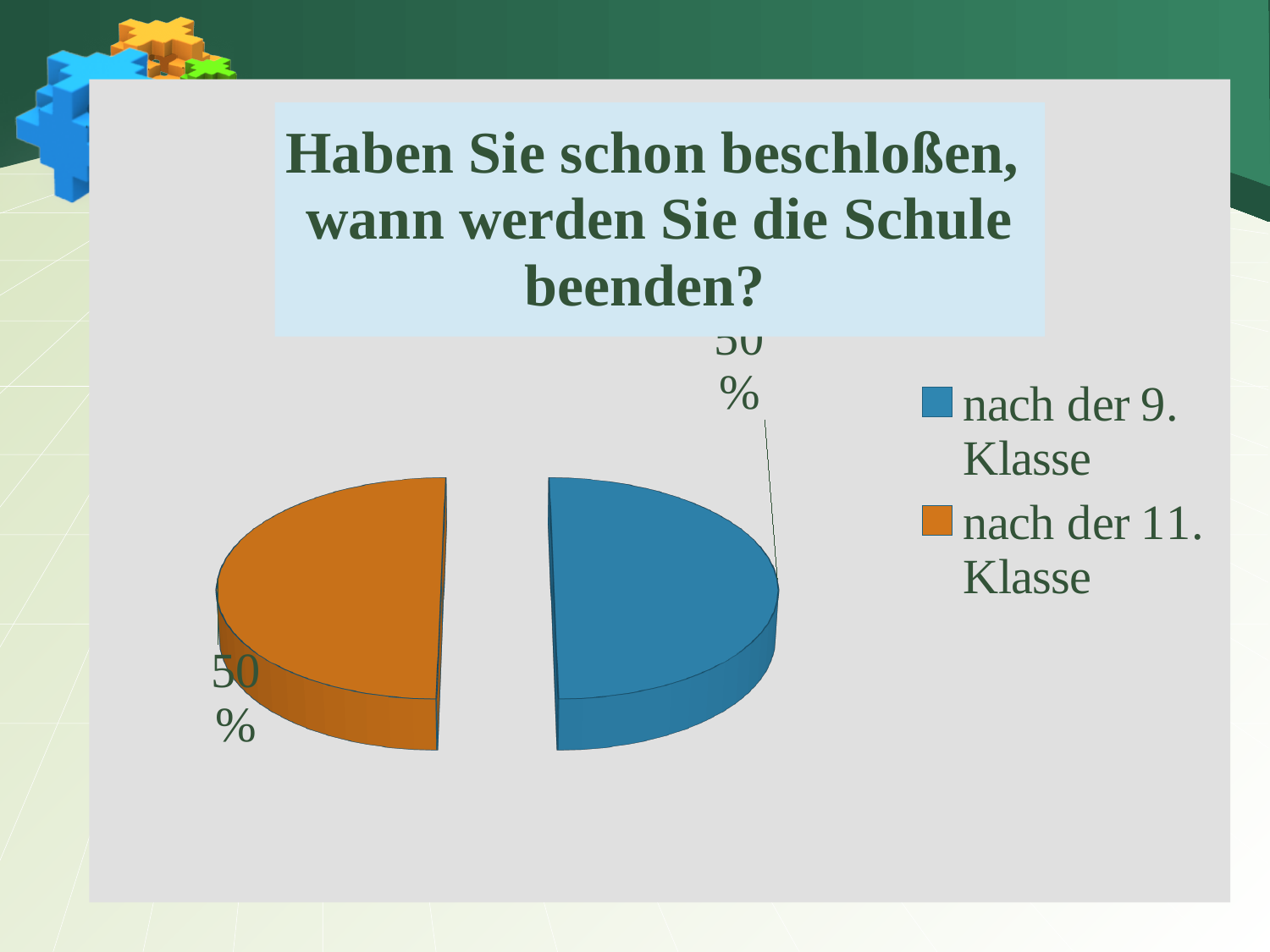
What is the difference between the percentages for "nach der 9. Klasse" and "nach der 11. Klasse"? 0% How many slices does the pie chart have? 2 What share of the pie does the "nach der 11. Klasse" slice represent? 50% Which colour represents "nach der 11. Klasse" in the pie chart? orange What is the title of the chart on the slide? Haben Sie schon beschloßen, wann werden Sie die Schule beenden? What percentage is shown for the slice "nach der 9. Klasse"? 50% What percentage is shown for the slice "nach der 11. Klasse"? 50% What share of the pie does the "nach der 9. Klasse" slice represent? 50% How many entries does the legend of the pie chart list? 2 What kind of chart is shown on the slide? pie chart